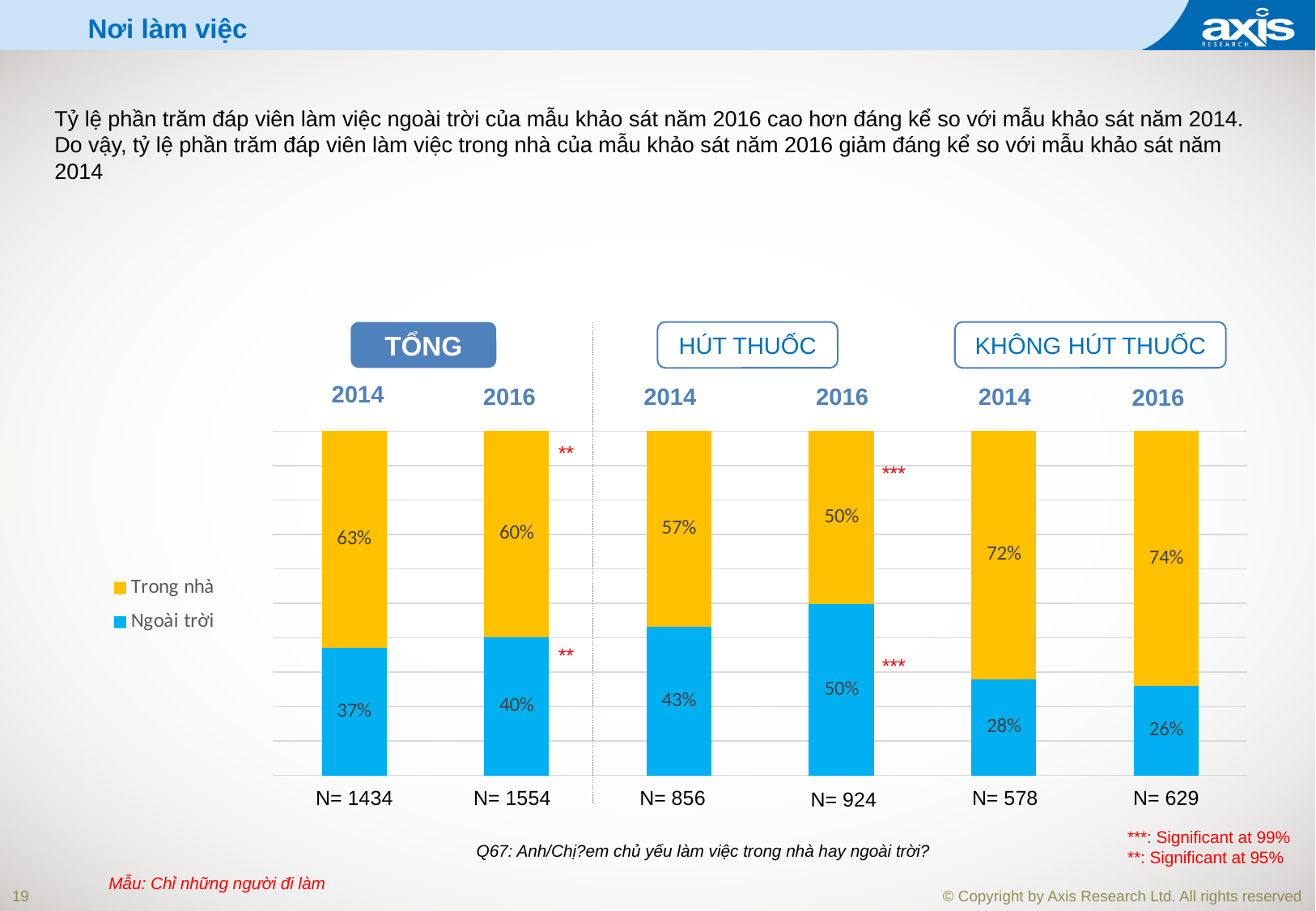
What is the Ngoài trời value for HÚT THUỐC 2016? 50% What kind of chart is shown on the slide? Stacked bar chart Which bar has the highest Trong nhà value? KHÔNG HÚT THUỐC 2016 What is the Trong nhà value for TỔNG 2014? 63% What is the Ngoài trời value for KHÔNG HÚT THUỐC 2014? 28% Which bar has the lowest Ngoài trời value? KHÔNG HÚT THUỐC 2016 Which is larger: the Ngoài trời value for HÚT THUỐC 2014 or for KHÔNG HÚT THUỐC 2014? HÚT THUỐC 2014 How many stacked bars are shown in the chart? 6 How many series does the legend list? 2 What is the difference between the Ngoài trời values for TỔNG 2016 and TỔNG 2014? 3% What is the sample size (N) shown under the HÚT THUỐC 2016 bar? N= 924 What is the Trong nhà value for KHÔNG HÚT THUỐC 2016? 74%